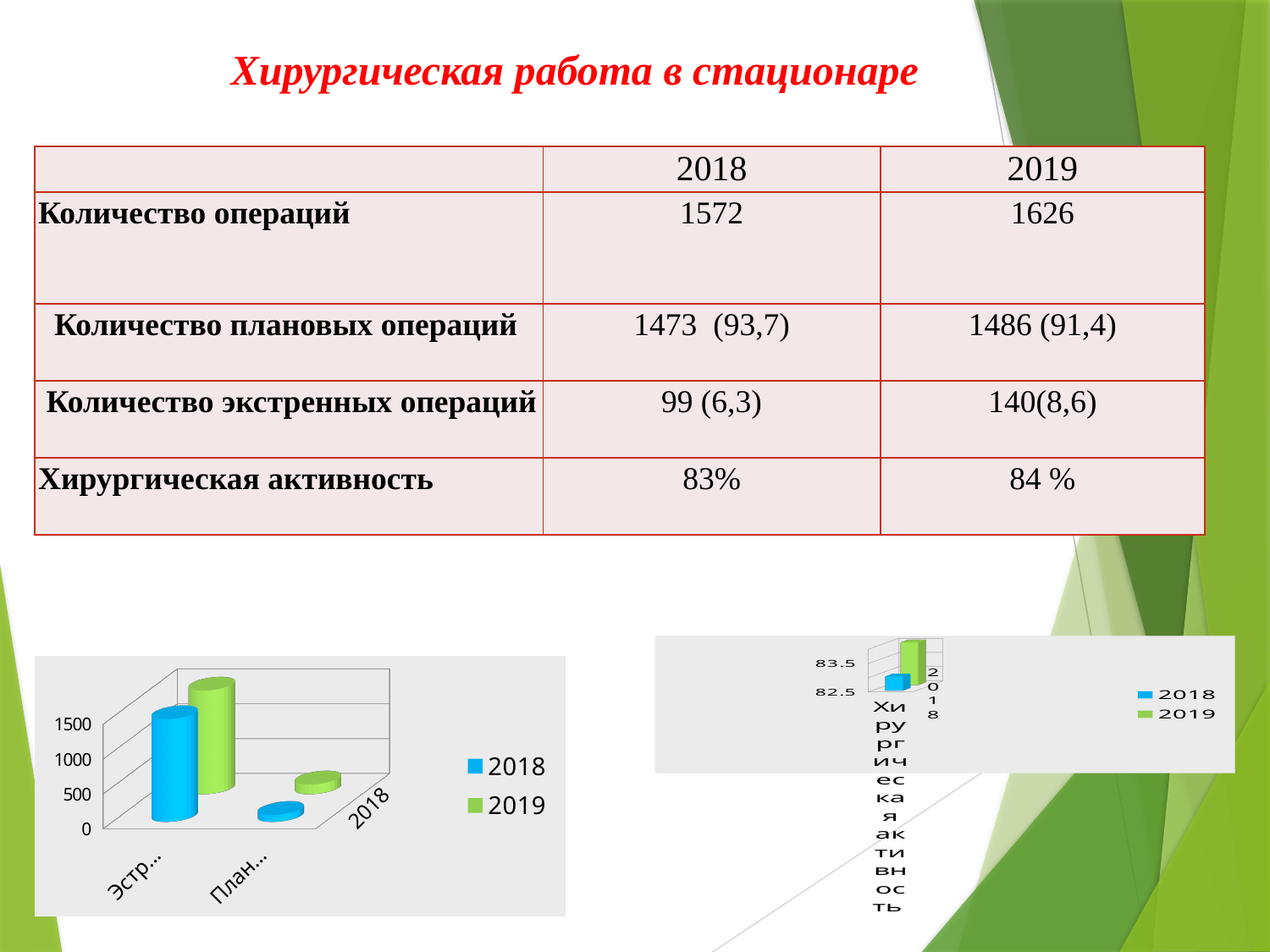
What is the highest tick label on the vertical axis of the bottom-left chart? 1500 What kind of chart is the small chart at the bottom right of the slide? bar chart In the bottom-left chart, is the 2018 value for 'Экстр...' greater or less than 500? greater How many series does the legend of the bottom-left chart list? 2 In the bottom-left chart, which category has the taller bars, 'Экстр...' or 'План...'? Эстр... Which series are listed in the legend of the bottom-left chart? 2018 and 2019 In the bottom-right chart, which series has the taller bar, 2018 or 2019? 2019 What kind of chart is the chart at the bottom left of the slide? bar chart How many categories are shown on the x axis of the bottom-left chart? 2 How many series does the legend of the bottom-right chart list? 2 In the bottom-left chart, is the 2019 value for 'План...' greater or less than 1000? less In the bottom-left chart, is the 2019 value for 'Экстр...' greater or less than 500? greater